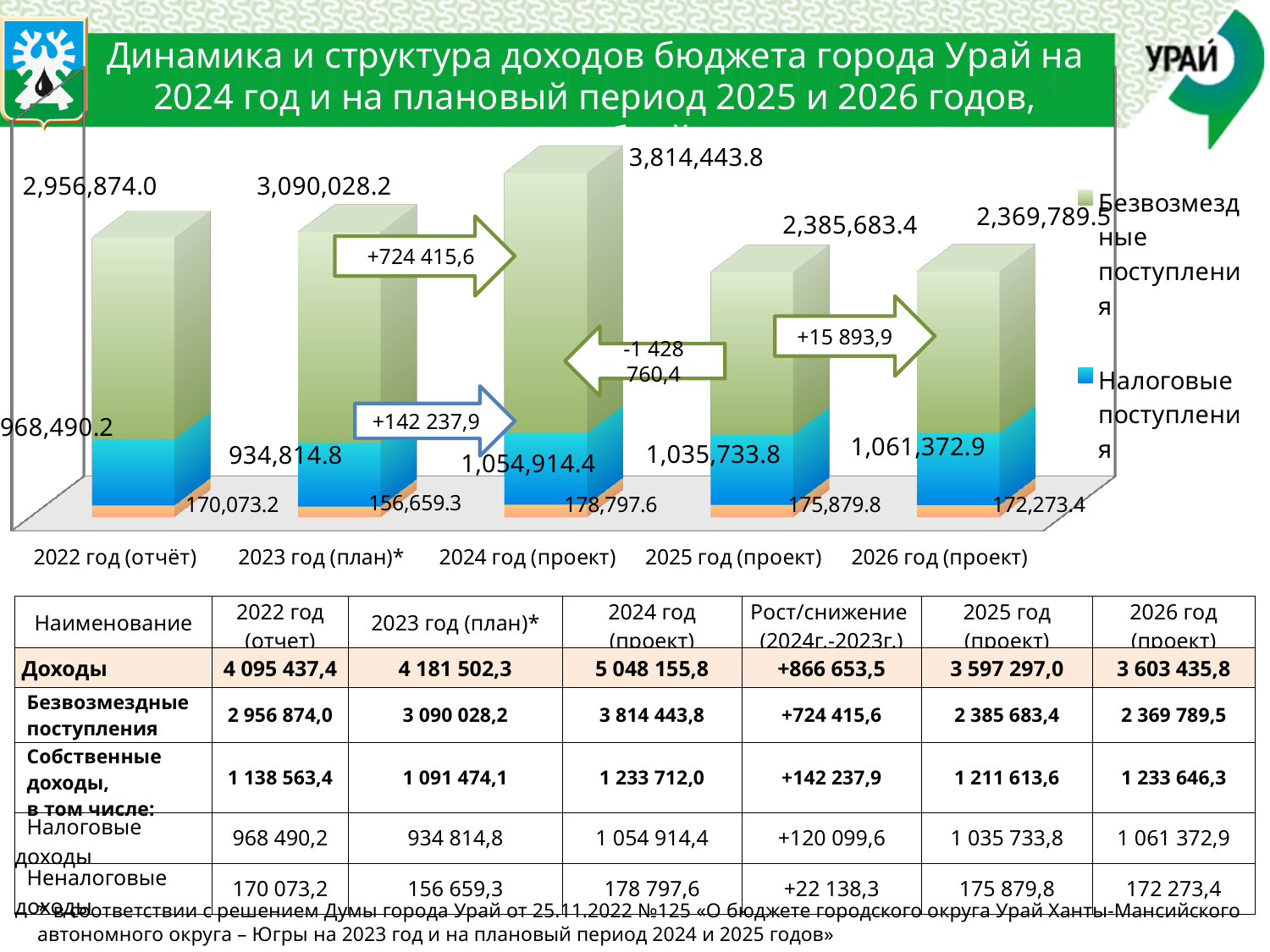
How many years (categories) are shown on the x axis of the chart? 5 In which year is Безвозмездные поступления highest? 2024 год (проект) What is the total of the stacked bar for 2022 год (отчёт)? 4,095,437.4 What is the difference in Безвозмездные поступления between 2024 год (проект) and 2023 год (план)*? 724,415.6 What is the value of Безвозмездные поступления for 2024 год (проект)? 3,814,443.8 In which year is Налоговые поступления lowest? 2023 год (план)* In which year is Налоговые поступления highest? 2026 год (проект) Which is larger: Налоговые поступления in 2025 год (проект) or in 2026 год (проект)? 2026 год (проект) Which series is shown in green in the chart legend? Безвозмездные поступления What is the value of the bottom (orange) segment for 2025 год (проект)? 175,879.8 What type of chart is shown on the slide? Stacked bar chart What is the value of Налоговые поступления for 2023 год (план)*? 934,814.8